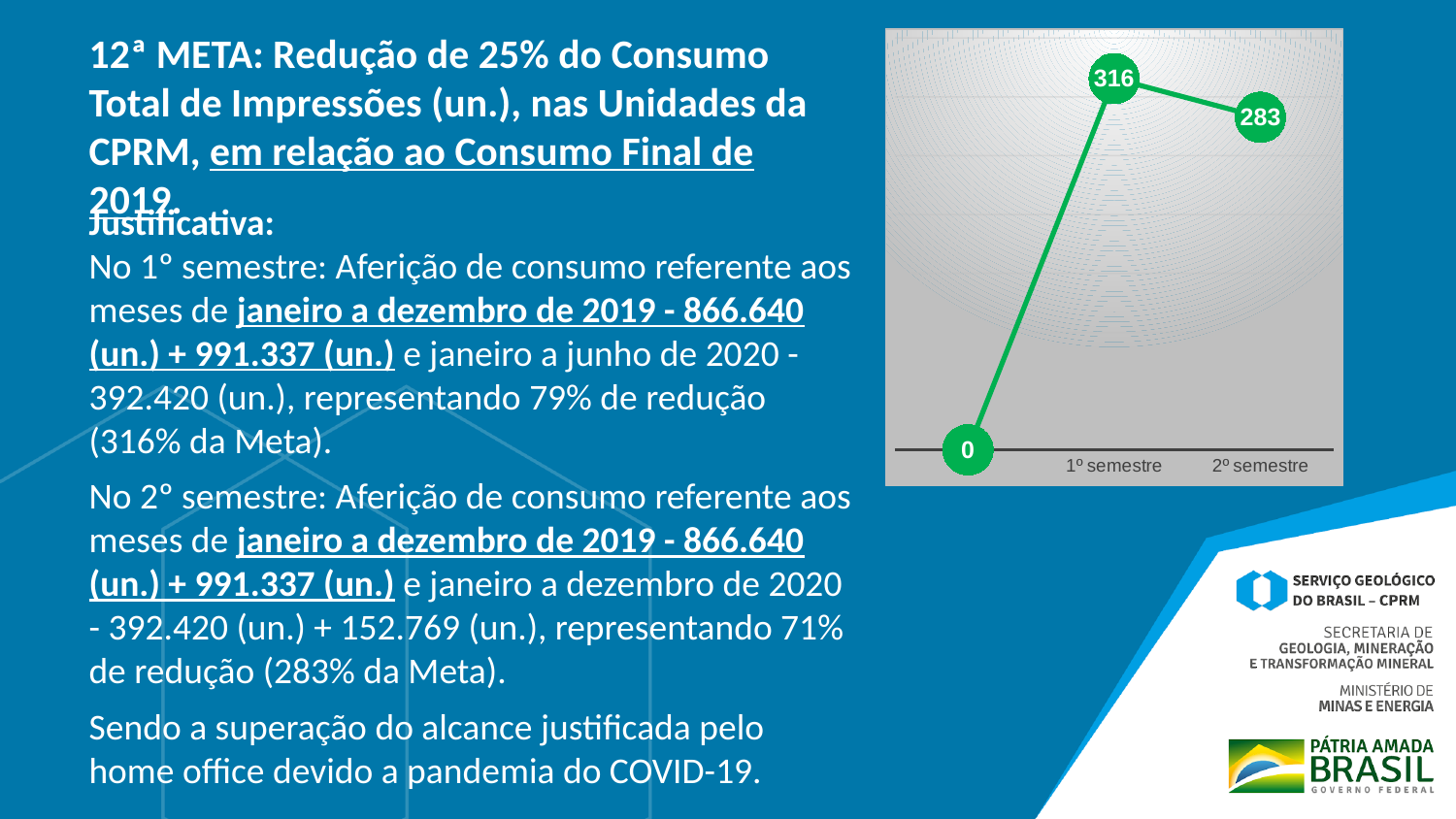
What kind of chart is shown on the slide? line chart Which labelled semester has the higher value? 1º semestre How many category labels are shown on the x axis of the chart? 2 Is the value for 1º semestre larger or smaller than the value for 2º semestre? larger What is the value of the first point on the line, at the left end of the chart? 0 What colour is the line in the chart? green How many data points are plotted on the line? 3 Does the line rise or fall between 1º semestre and 2º semestre? falls What is the value plotted for 1º semestre? 316 Which labelled semester has the lower value? 2º semestre What is the difference between the values for 1º semestre and 2º semestre? 33 What is the value plotted for 2º semestre? 283